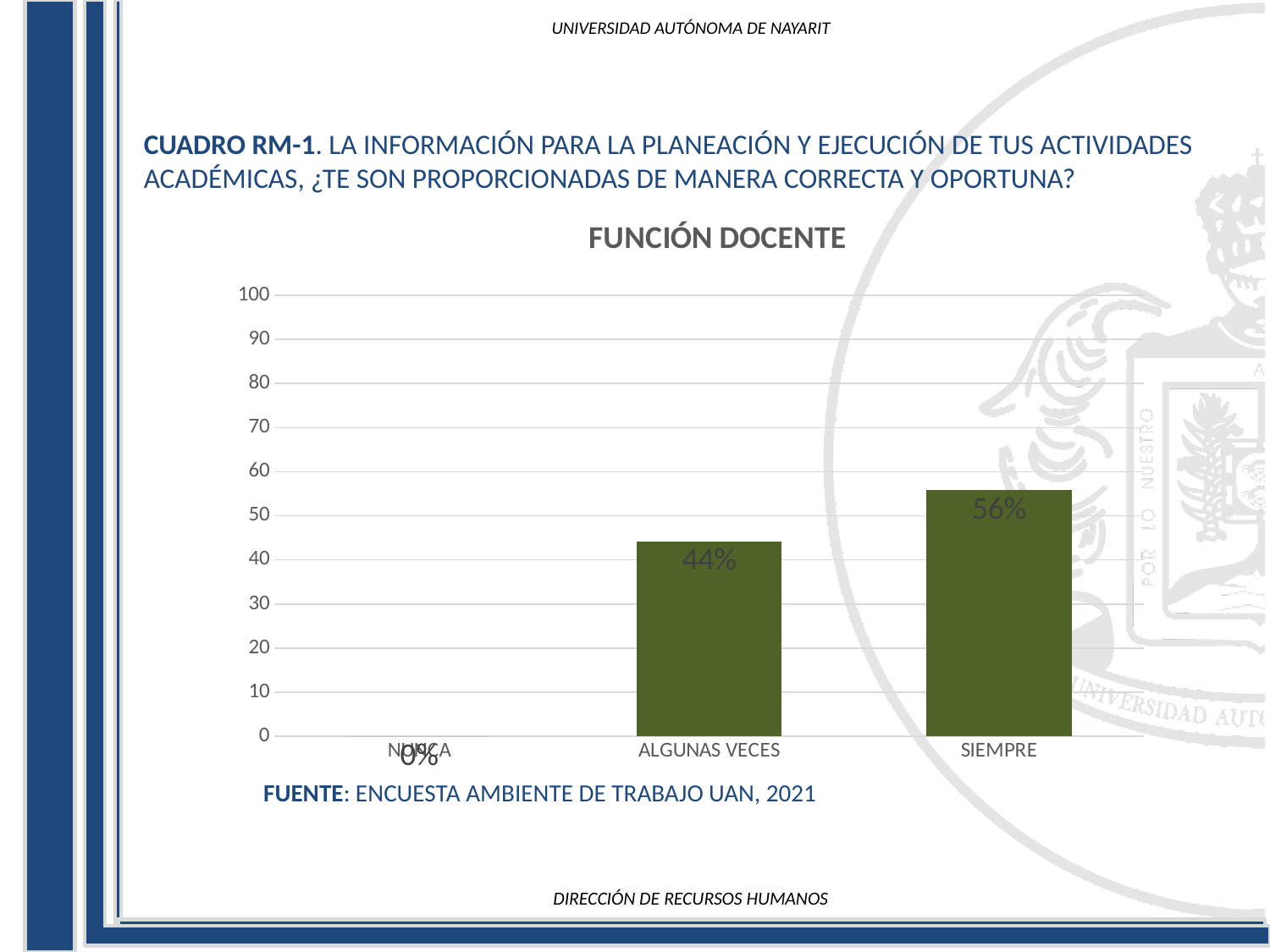
What kind of chart is shown? bar chart What is the value for NUNCA? 0% Which category has the lowest value? NUNCA Do the values rise or fall from left to right along the x axis? rise What is the difference between the values for SIEMPRE and ALGUNAS VECES? 12% Is the value for ALGUNAS VECES greater or less than 50? less Which category has the highest value? SIEMPRE What is the title of the chart? FUNCIÓN DOCENTE Which is larger, the value for ALGUNAS VECES or the value for SIEMPRE? SIEMPRE How many categories are shown on the x axis? 3 What is the value for SIEMPRE? 56% What is the value for ALGUNAS VECES? 44%